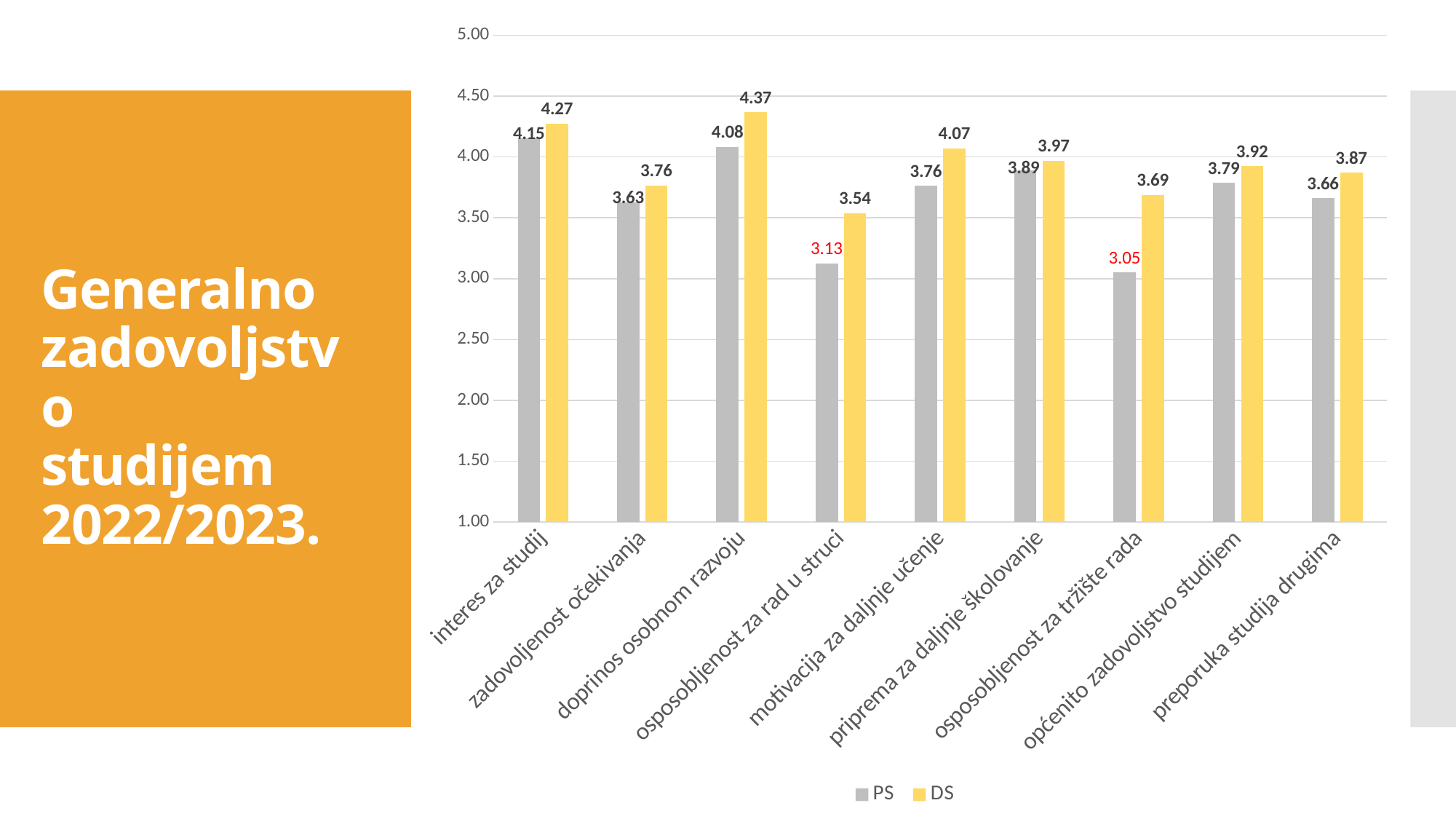
What is the DS value for "preporuka studija drugima"? 3.87 What is the DS value for "doprinos osobnom razvoju"? 4.37 Which category has the highest DS value? doprinos osobnom razvoju Which category has the lowest PS value? osposobljenost za tržište rada What is the PS value for "osposobljenost za tržište rada"? 3.05 How many series does the legend list? 2 What kind of chart is shown on the slide? bar chart What is the difference between the DS and PS values for "osposobljenost za rad u struci"? 0.41 Which is larger for "motivacija za daljnje učenje", the PS value or the DS value? DS How many categories are shown on the x axis? 9 Is the PS value for "zadovoljenost očekivanja" greater or less than 4.00? less What is the PS value for "interes za studij"? 4.15